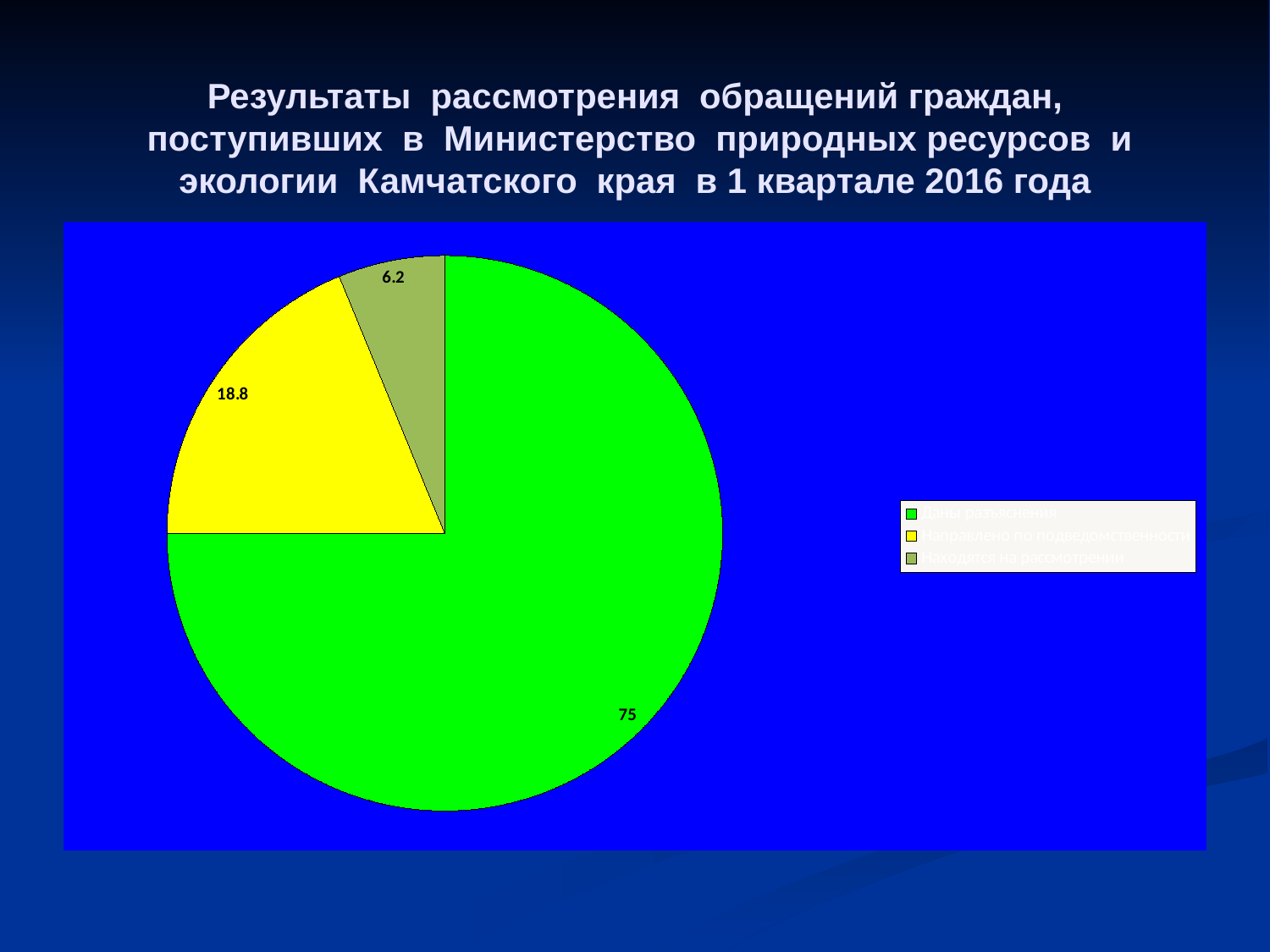
What is the difference between the green slice value and the yellow slice value? 56.2 Which slice of the pie chart is the largest? the green slice (Даны разъяснения) Which quarter and year does the slide title say the data refers to? 1 квартал 2016 года How many entries does the legend of the pie chart list? 3 What value is labelled on the yellow slice of the pie chart? 18.8 What is the difference between the yellow slice value and the grey-green slice value? 12.6 What value is labelled on the green slice of the pie chart? 75 How many slices does the pie chart have? 3 What value is labelled on the grey-green slice of the pie chart? 6.2 Which slice of the pie chart is the smallest? the grey-green slice (Находятся на рассмотрении) What type of chart is shown on the slide? pie chart Which is larger: the yellow slice or the grey-green slice? the yellow slice